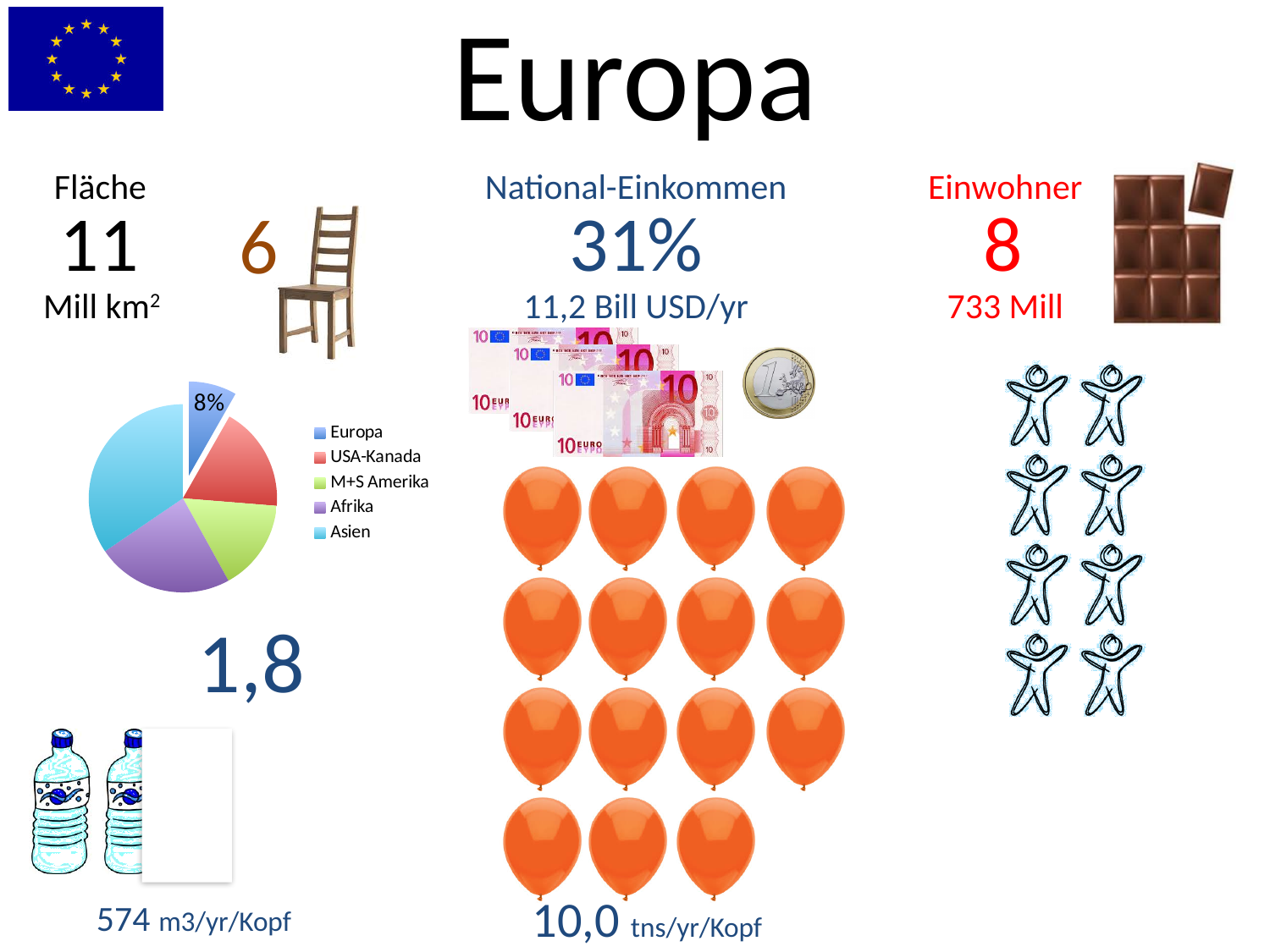
How many categories does the pie chart show? 5 Which category has the largest slice in the pie chart? Asien Which slice of the pie chart is pulled out (exploded) from the rest? Europa What kind of chart is shown on the slide? pie chart Which category is listed first in the legend of the pie chart? Europa Which category has the smallest slice in the pie chart? Europa Which slice is larger in the pie chart, Afrika or M+S Amerika? Afrika Which slice is larger in the pie chart, Asien or Europa? Asien How many entries does the legend of the pie chart list? 5 What share of the pie chart does Europa have? 8% Which slice is larger in the pie chart, USA-Kanada or Europa? USA-Kanada